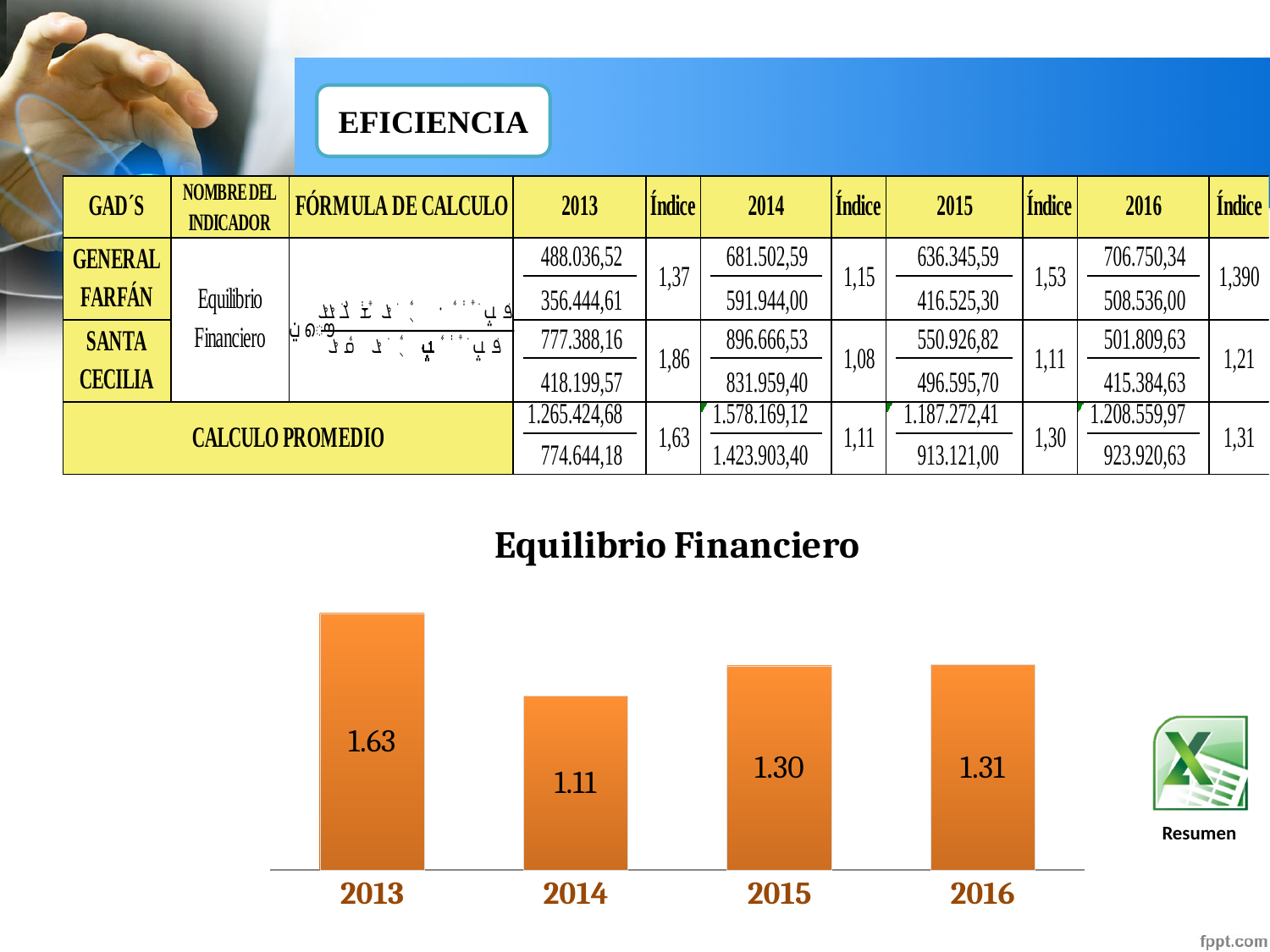
What is the value for 2014 in the Equilibrio Financiero chart? 1.11 What is the difference between the 2013 and 2014 values in the Equilibrio Financiero chart? 0.52 In the Equilibrio Financiero chart, does the value rise or fall from 2013 to 2014? fall What is the difference between the 2016 and 2015 values in the Equilibrio Financiero chart? 0.01 What is the value for 2013 in the Equilibrio Financiero chart? 1.63 How many years are shown in the Equilibrio Financiero chart? 4 What is the value for 2015 in the Equilibrio Financiero chart? 1.30 In the Equilibrio Financiero chart, which is larger, the value for 2013 or the value for 2015? 2013 Which year has the highest value in the Equilibrio Financiero chart? 2013 What is the value for 2016 in the Equilibrio Financiero chart? 1.31 What kind of chart is the Equilibrio Financiero chart? bar chart Which year has the lowest value in the Equilibrio Financiero chart? 2014